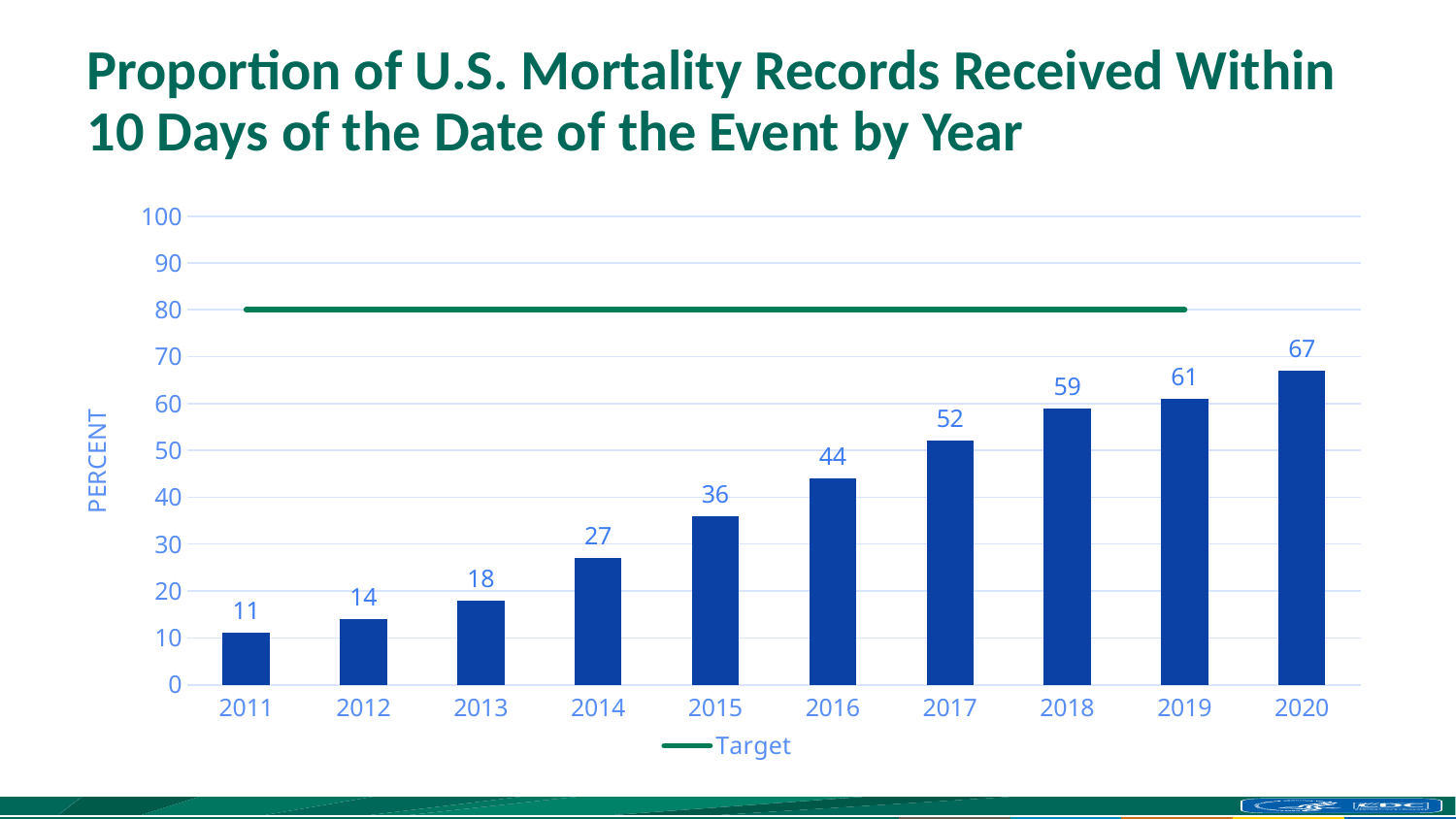
How many years are shown on the x axis? 10 Which year has the lowest value? 2011 What is the difference between the values for 2020 and 2011? 56 Is the Target line greater or less than 70? greater What is the value for 2018? 59 What is the value for 2011? 11 What is the label of the y axis? PERCENT Which is larger, the value for 2016 or the value for 2017? 2017 What is the value for 2015? 36 Do the bar values rise or fall from 2011 to 2020? rise What kind of chart is this? bar chart Which year has the highest value? 2020